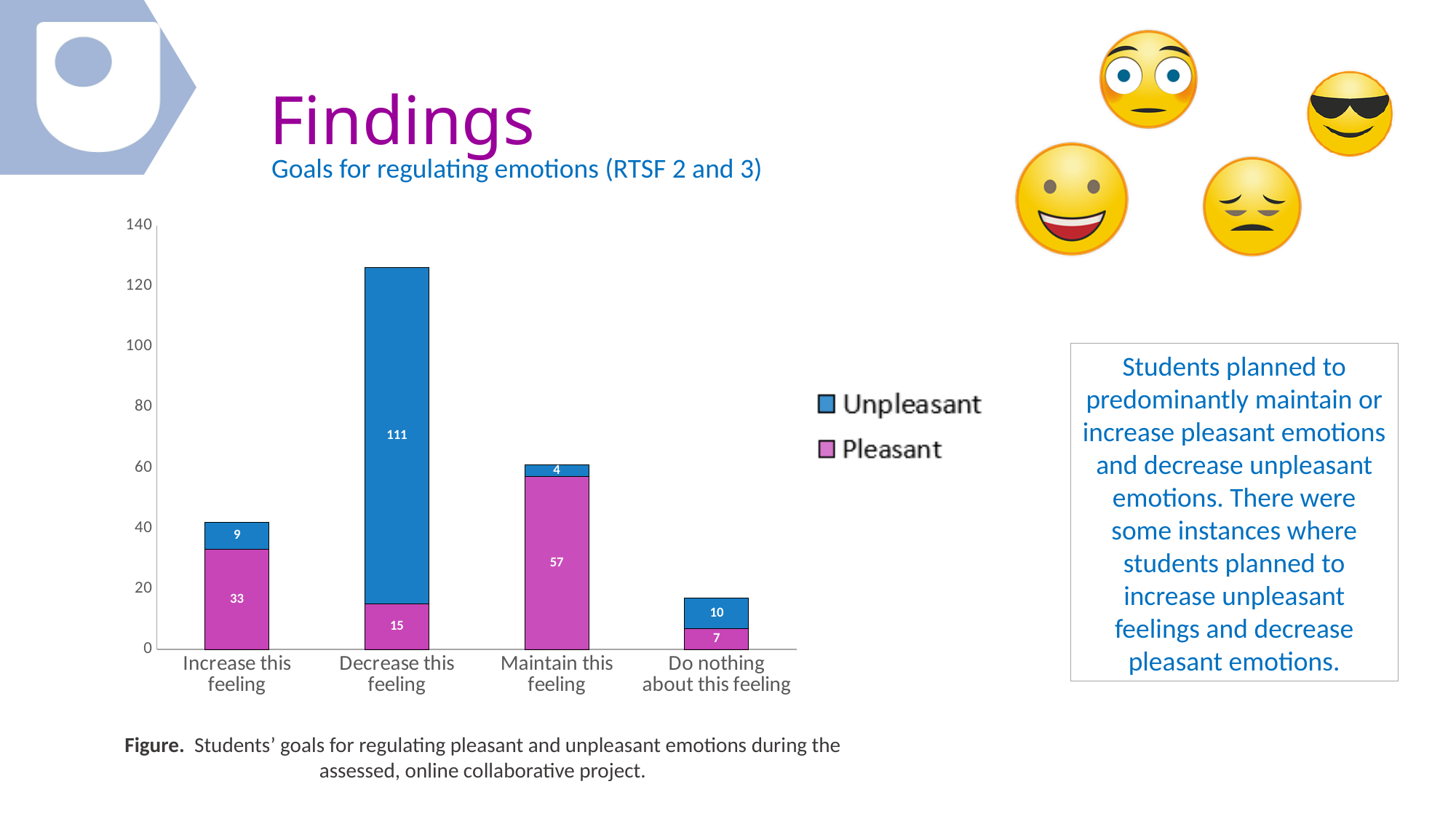
How many series does the legend list? 2 What is the total of the stacked bar for 'Increase this feeling'? 42 Which category has the highest Unpleasant value? Decrease this feeling What is the total of the stacked bar for 'Maintain this feeling'? 61 What is the Pleasant value for 'Maintain this feeling'? 57 What is the Unpleasant value for 'Do nothing about this feeling'? 10 What is the Pleasant value for 'Increase this feeling'? 33 How many categories are shown on the x axis? 4 What is the Unpleasant value for 'Decrease this feeling'? 111 What is the difference between the Unpleasant and Pleasant values for 'Decrease this feeling'? 96 Which is larger: the Pleasant value for 'Increase this feeling' or the Pleasant value for 'Decrease this feeling'? Increase this feeling Which category has the lowest Pleasant value? Do nothing about this feeling